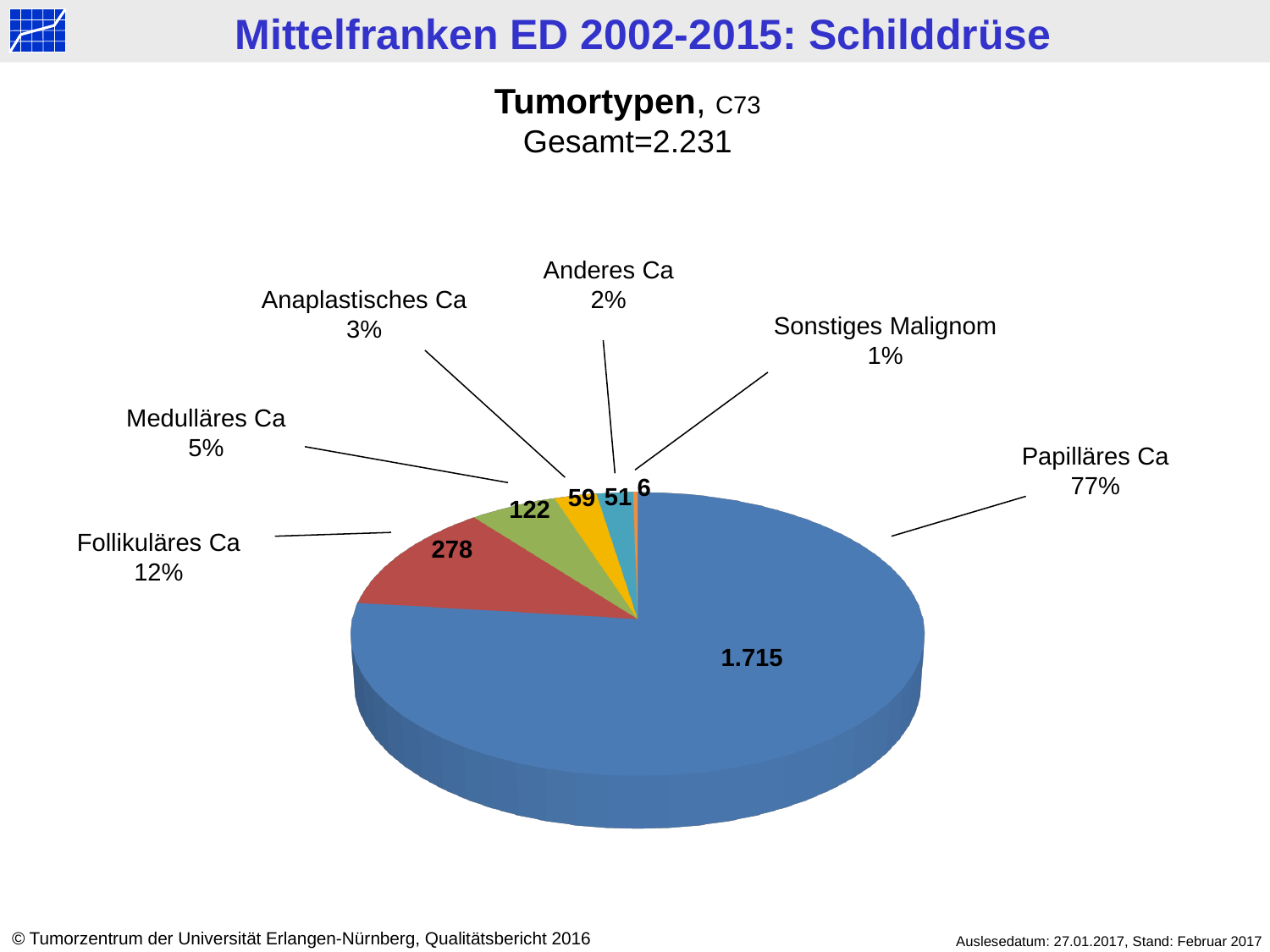
Which tumour type has the smallest slice? Sonstiges Malignom What is the value for Sonstiges Malignom? 6 What share of the pie does Papilläres Ca represent? 77% What is the value for Medulläres Ca? 122 What kind of chart is shown on the slide? pie chart How many slices does the pie chart have? 6 What share of the pie does Anaplastisches Ca represent? 3% What is the difference between the values for Follikuläres Ca and Medulläres Ca? 156 Which tumour type has the largest slice? Papilläres Ca What is the value for Follikuläres Ca? 278 Which is larger, the value for Anaplastisches Ca or the value for Anderes Ca? Anaplastisches Ca What is the value for Papilläres Ca? 1.715